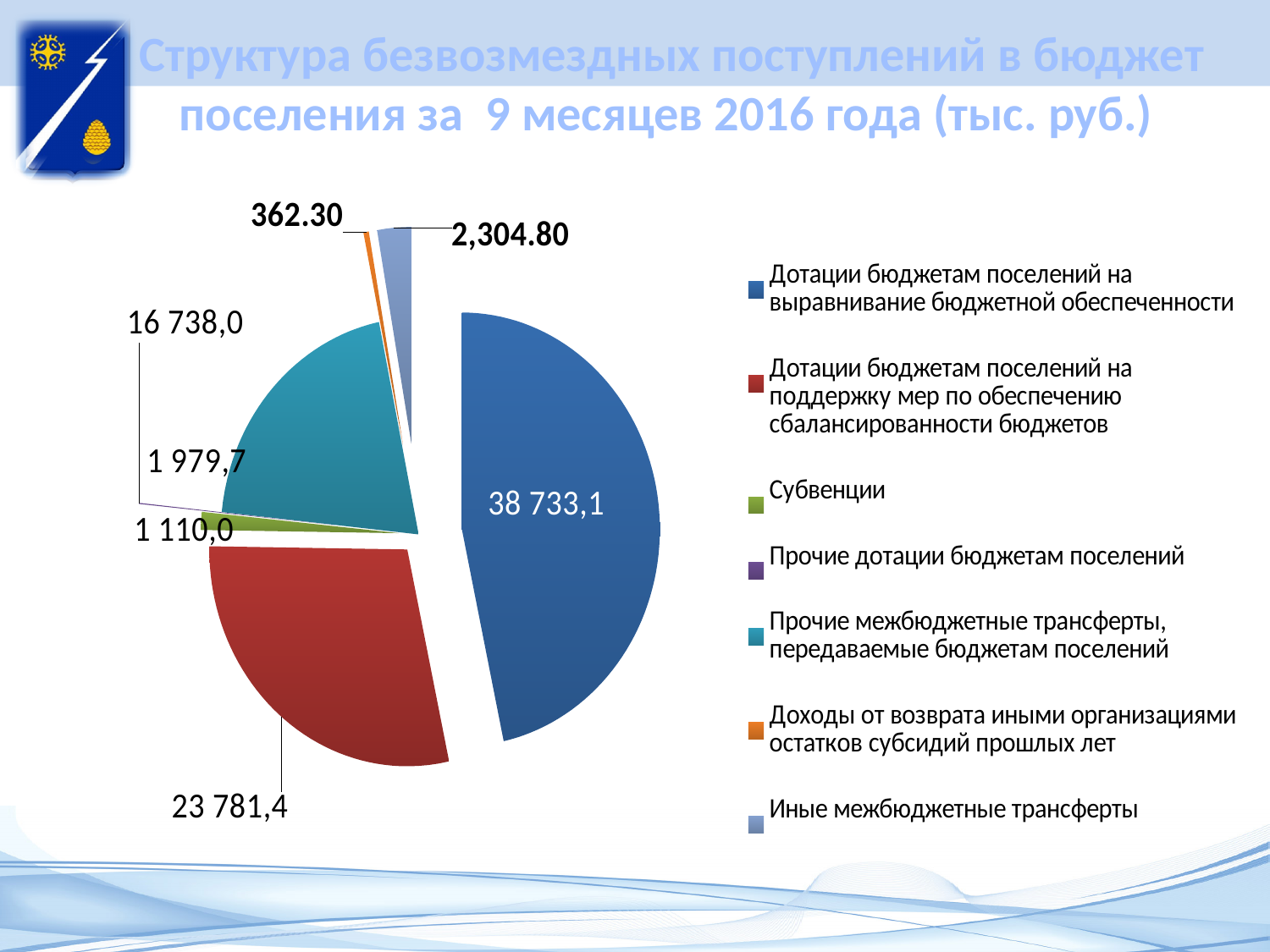
What is the value for Дотации бюджетам поселений на выравнивание бюджетной обеспеченности? 38 733,1 What is the value for Прочие межбюджетные трансферты, передаваемые бюджетам поселений? 16 738,0 What type of chart is shown on the slide? pie chart What is the value for Иные межбюджетные трансферты? 2,304.80 Which is larger: the value for Прочие межбюджетные трансферты, передаваемые бюджетам поселений or the value for Иные межбюджетные трансферты? Прочие межбюджетные трансферты, передаваемые бюджетам поселений What is the difference between the value for Дотации бюджетам поселений на выравнивание бюджетной обеспеченности and the value for Дотации бюджетам поселений на поддержку мер по обеспечению сбалансированности бюджетов? 14 951,7 What is the value for Доходы от возврата иными организациями остатков субсидий прошлых лет? 362.30 What unit of measurement is stated in the chart title? тыс. руб. What is the value for Дотации бюджетам поселений на поддержку мер по обеспечению сбалансированности бюджетов? 23 781,4 Which category has the largest slice of the pie? Дотации бюджетам поселений на выравнивание бюджетной обеспеченности How many categories does the pie chart have? 7